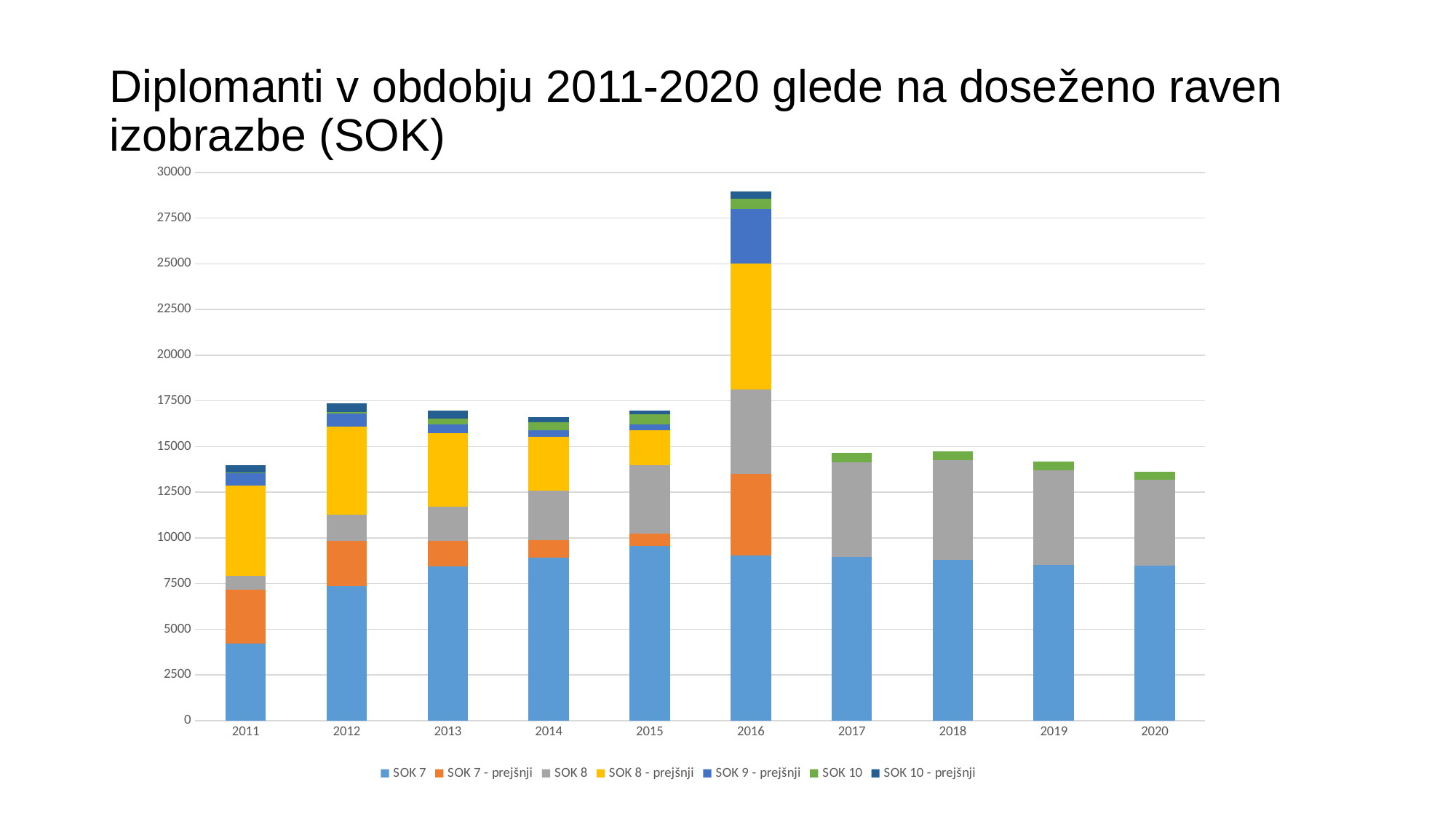
Is the total for 2016 greater or less than 25000? greater What kind of chart is shown on the slide? stacked bar chart How many series does the legend list? 7 What is the title of the chart? Diplomanti v obdobju 2011-2020 glede na doseženo raven izobrazbe (SOK) Is the SOK 7 value for 2011 greater or less than 5000? less Is the total for 2011 greater or less than 15000? less Which series is shown in yellow in the legend? SOK 8 - prejšnji How many years (categories) are shown on the x axis? 10 Which year has the larger total, 2015 or 2016? 2016 Which year has the larger SOK 7 value, 2011 or 2012? 2012 Which year has the highest total stacked bar? 2016